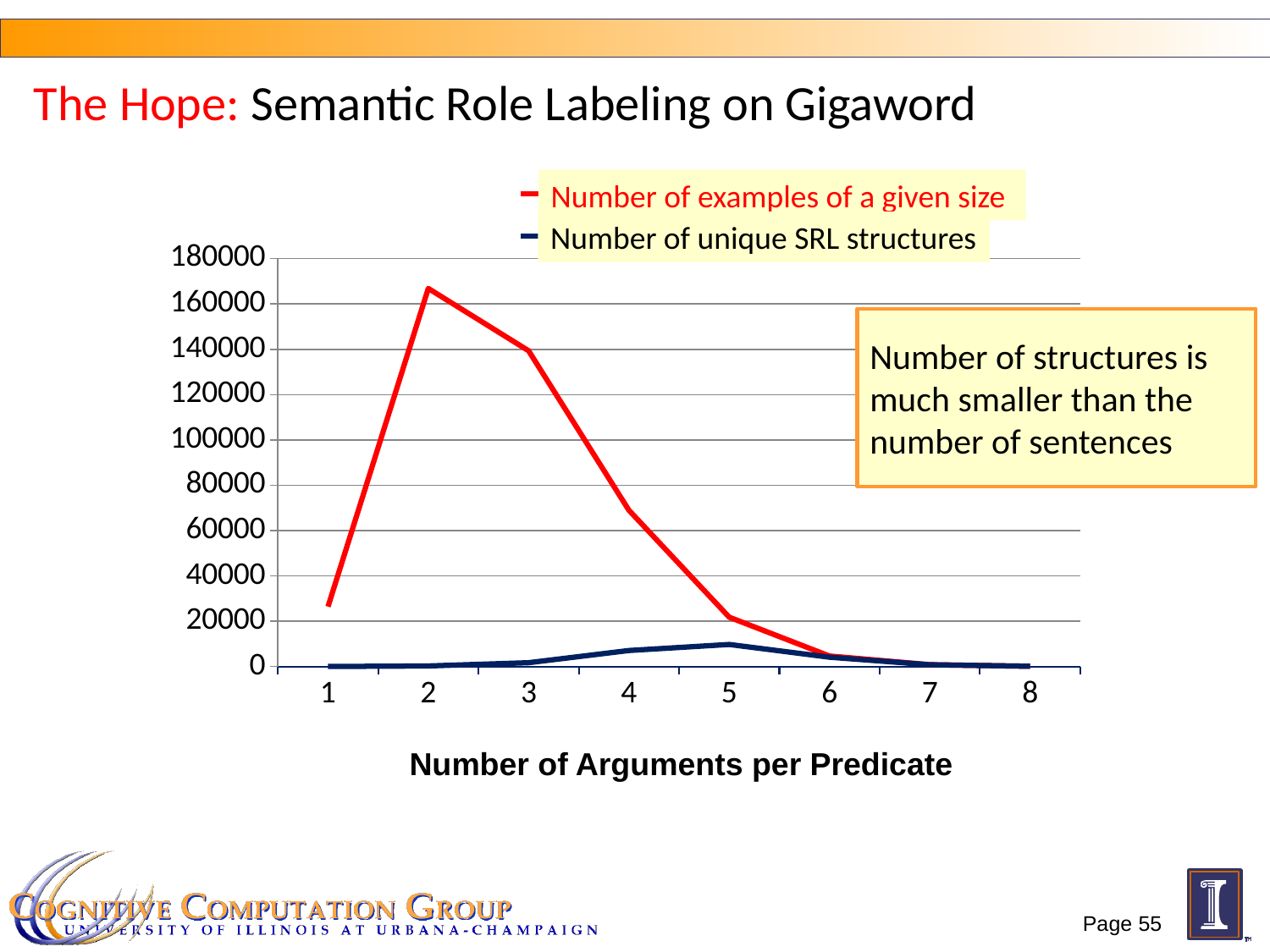
Is the value of 'Number of examples of a given size' at 4 arguments greater or less than 60000? greater Which series is drawn in red? Number of examples of a given size Which series has the larger value at 3 arguments per predicate? Number of examples of a given size Is the value of 'Number of examples of a given size' at 2 arguments greater or less than 160000? greater What is the title of the x axis? Number of Arguments per Predicate How many series does the legend list? 2 At which number of arguments per predicate does the 'Number of unique SRL structures' line reach its highest value? 5 What kind of chart is shown on the slide? line chart At which number of arguments per predicate does the 'Number of examples of a given size' line reach its highest value? 2 Is the value of 'Number of examples of a given size' at 1 argument greater or less than 40000? less How many points along the x axis does each line have? 8 Does the 'Number of examples of a given size' line rise or fall from 2 to 8 arguments per predicate? fall